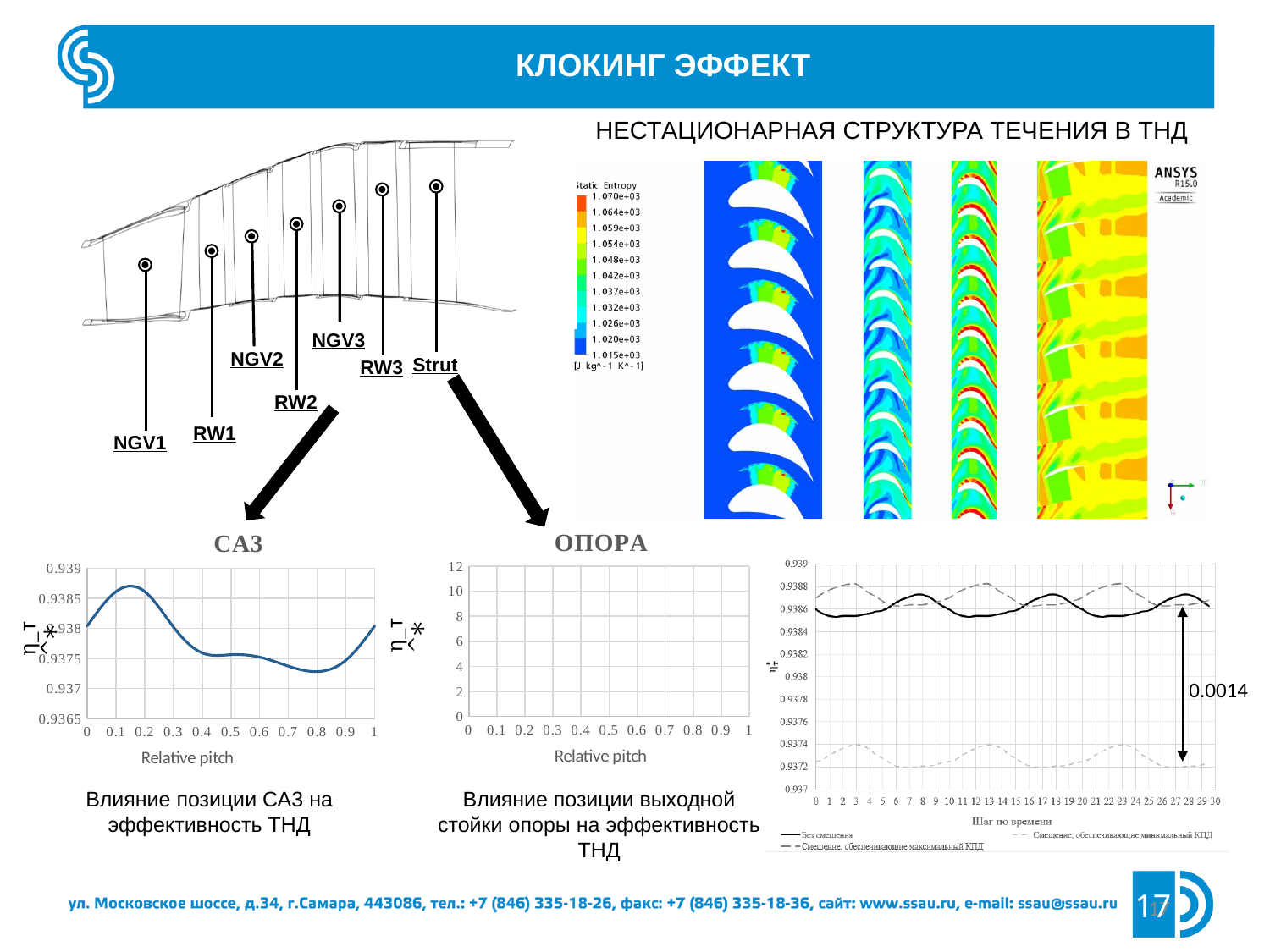
What is the lowest value shown on the y axis of the 'САЗ' chart? 0.9365 In the 'САЗ' chart, which is larger: the value at relative pitch 0.2 or at relative pitch 0.8? 0.2 What kind of chart is the 'САЗ' chart on the lower left of the slide? line chart In the 'САЗ' chart, does the curve rise or fall between relative pitch 0.2 and 0.5? fall What is the x-axis label of the 'ОПОРА' chart? Relative pitch What difference value is annotated with the vertical arrow on the lower-right chart? 0.0014 What is the highest value shown on the y axis of the 'ОПОРА' chart in the middle of the slide? 12 How many series does the legend of the chart on the lower right (x axis 'Шаг по времени') list? 3 In the lower-right chart, which series lies lowest: 'Без смещения' or 'Смещение, обеспечивающие минимальный КПД'? Смещение, обеспечивающие минимальный КПД In the 'САЗ' chart, is the value at relative pitch 0.8 greater or less than 0.9375? less In the 'САЗ' chart, is the value at relative pitch 0.2 greater or less than 0.938? greater What is the largest time step shown on the x axis of the lower-right chart? 30